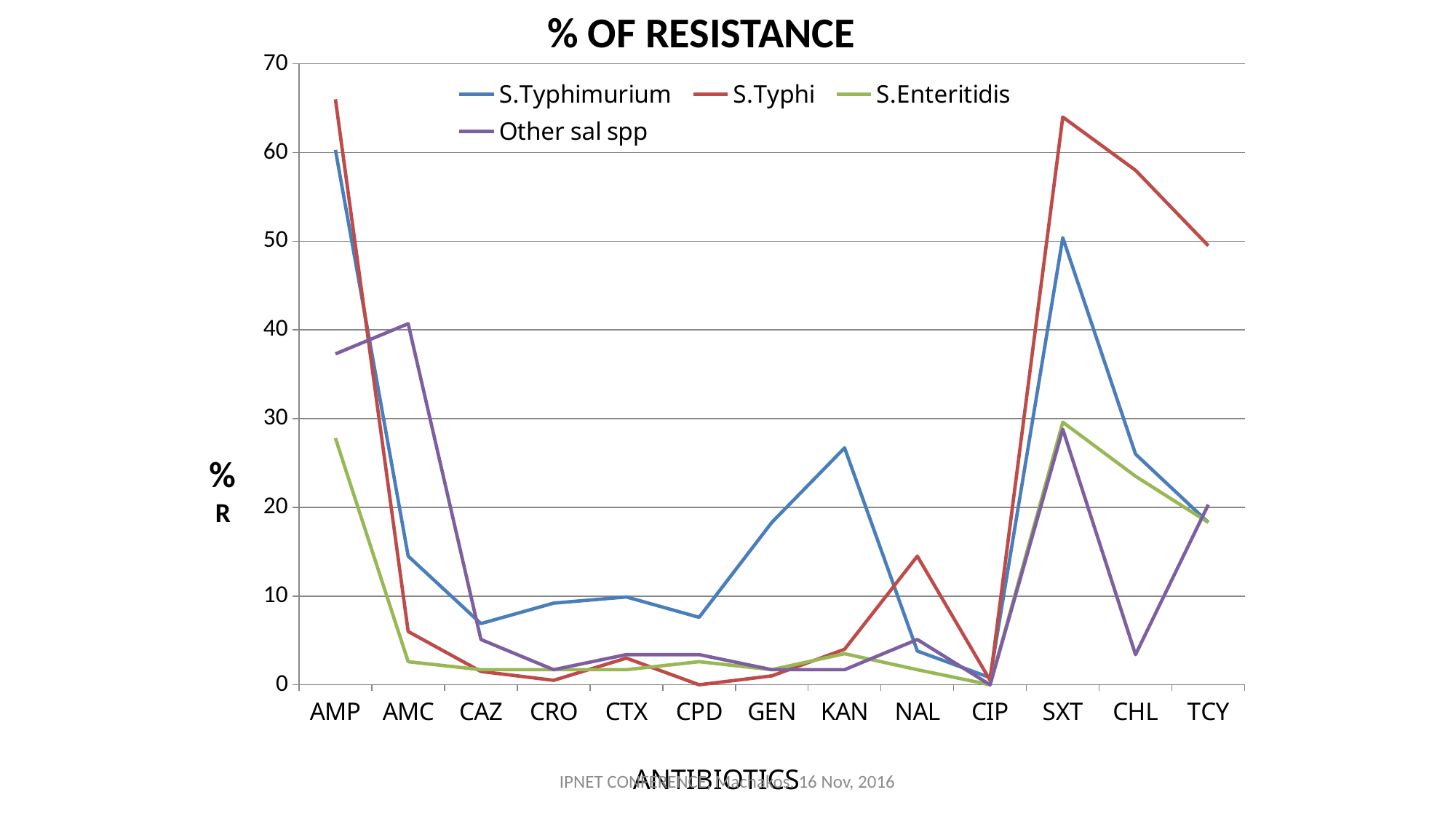
How many series does the legend list? 4 Is the value for S.Typhi at CHL greater or less than 60? less How many antibiotics are shown along the x axis? 13 What kind of chart is shown on the slide? line chart Which series has the highest value at AMC? Other sal spp Is the value for S.Enteritidis at AMP greater or less than 30? less Which series has the highest value at KAN? S.Typhimurium Is the value for S.Typhi at AMP greater or less than 60? greater What is the title of the chart? % OF RESISTANCE What is the x-axis title of the chart? ANTIBIOTICS Does the S.Typhi line rise or fall from SXT to TCY? fall Which series has the lowest value at CHL? Other sal spp